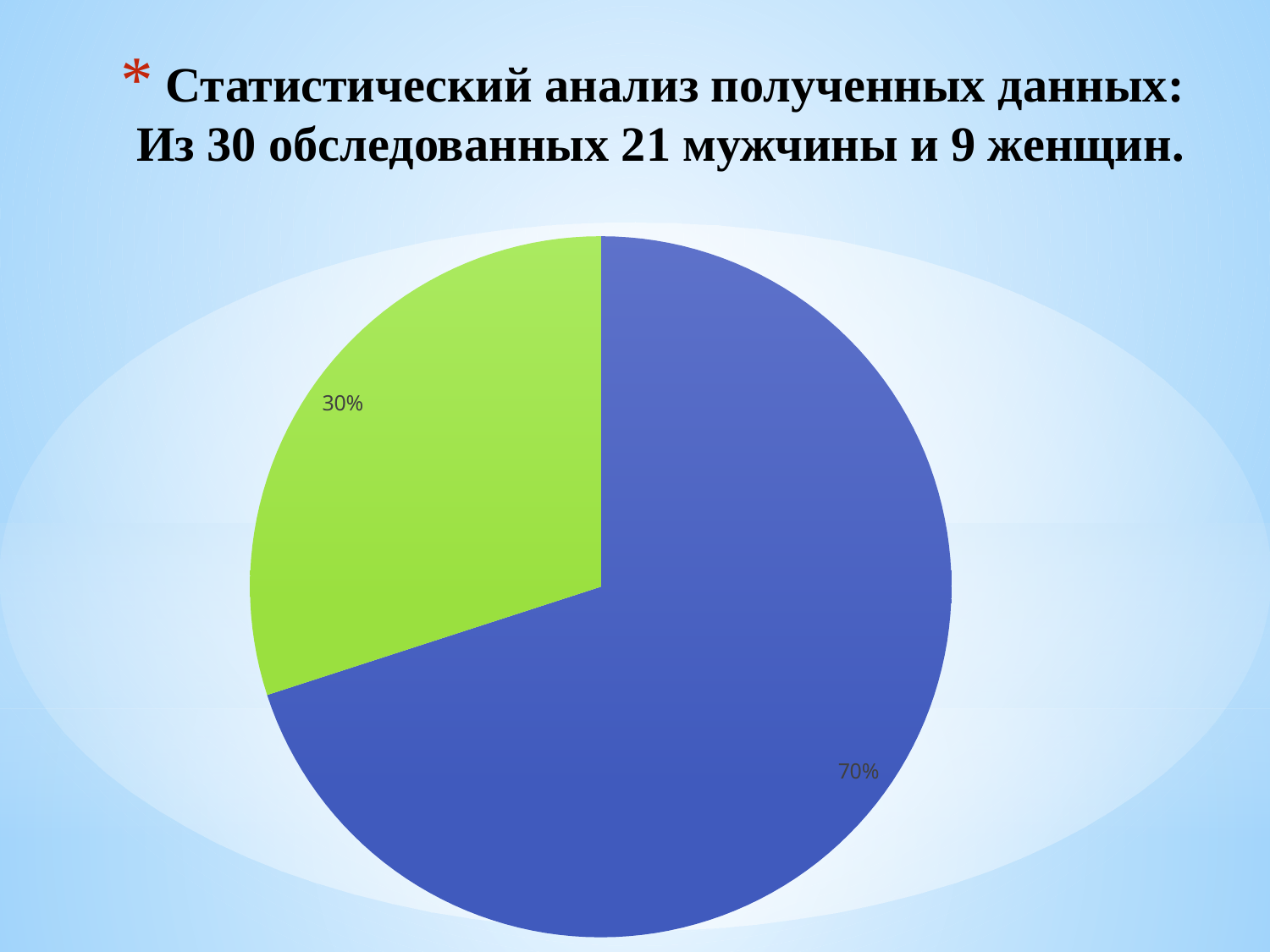
What kind of chart is shown on the slide? pie chart Which is larger, the blue slice or the green slice? the blue slice Which slice of the pie chart is the largest? the blue slice (70%) How many slices does the pie chart have? 2 Is the blue slice's share greater or less than 50%? greater What do the two slice percentages add up to? 100% Which slice of the pie chart is the smallest? the green slice (30%) What percentage is shown for the blue slice of the pie chart? 70% What percentage is shown for the green slice of the pie chart? 30% According to the slide title, how many people were examined in total? 30 What is the difference in percentage points between the blue slice and the green slice? 40 percentage points What two colours are used for the slices of the pie chart? blue and green